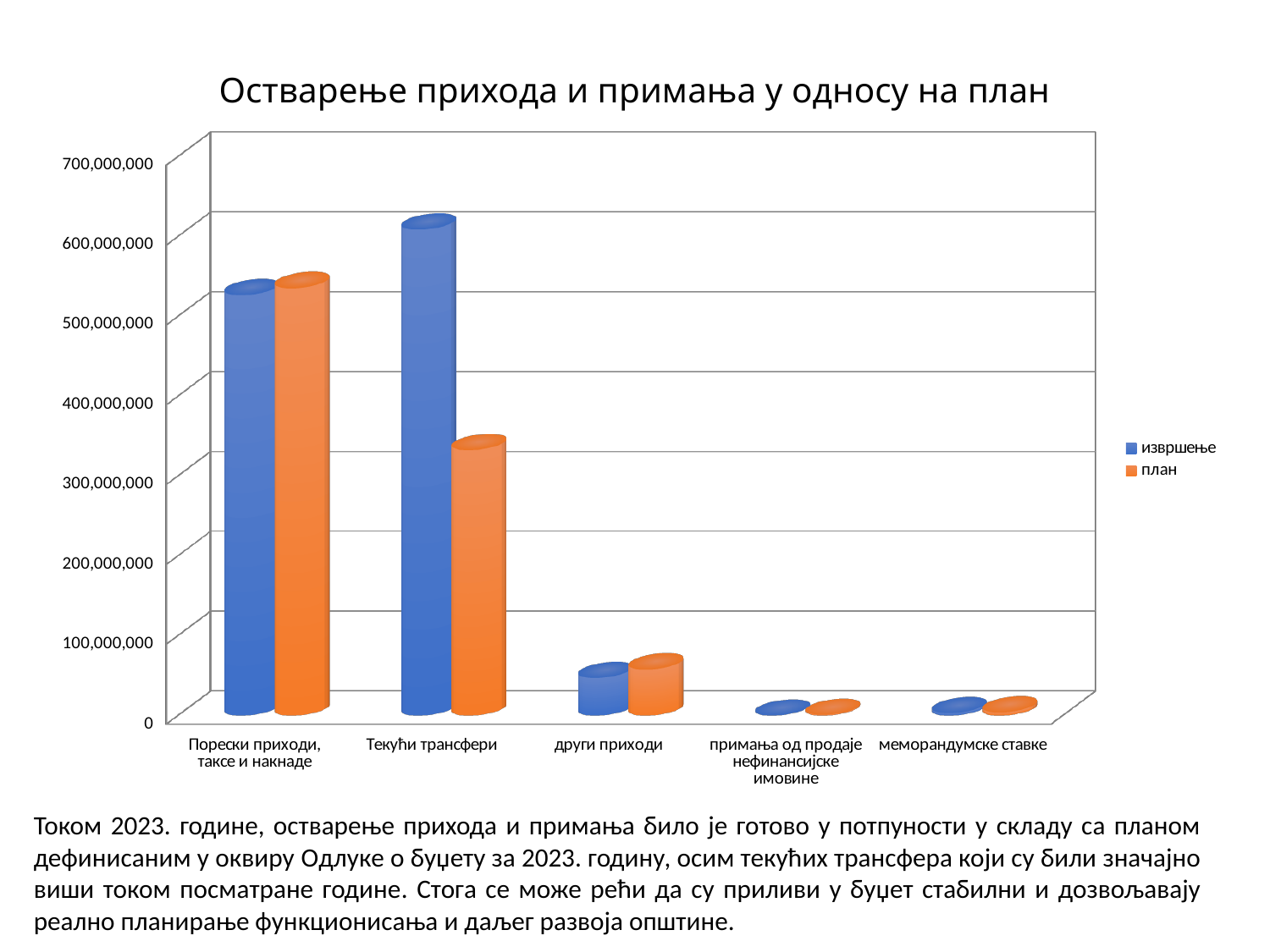
Is the извршење value for Текући трансфери greater or less than 500,000,000? greater For Текући трансфери, which is larger: извршење or план? извршење Which category has the highest value for план? Порески приходи, таксе и накнаде Is the план value for Текући трансфери greater or less than 400,000,000? less How many series does the legend list? 2 What kind of chart is shown on the slide? bar chart Is the план value for други приходи greater or less than 100,000,000? less Which colour represents the план series in the legend? orange How many categories are shown on the x axis? 5 What is the title of the chart? Остварење прихода и примања у односу на план Which category has the highest value for извршење? Текући трансфери